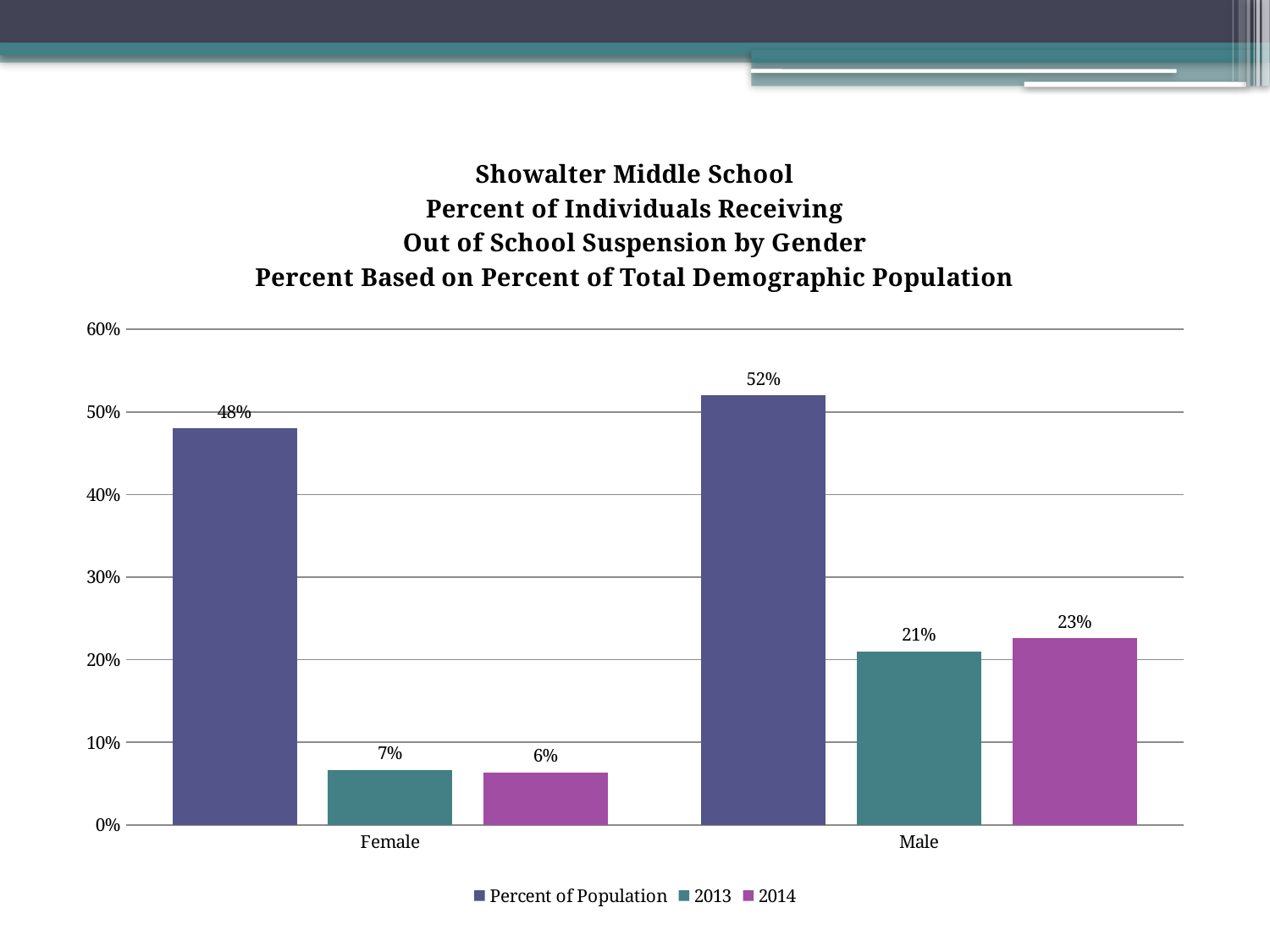
What is the 2013 value for Male? 21% What is the Percent of Population value for Female? 48% How many series does the legend list? 3 Is the 2014 value for Male larger or smaller than the 2013 value for Male? larger Which series is shown in purple/magenta in the legend? 2014 How many gender categories are shown on the x axis? 2 Is the Percent of Population value for Male greater or less than 50%? greater Which gender has the higher 2014 value? Male What kind of chart is shown on the slide? bar chart What is the 2014 value for Female? 6% What is the difference between the Male and Female 2013 values? 14% Which gender has the lower Percent of Population value? Female